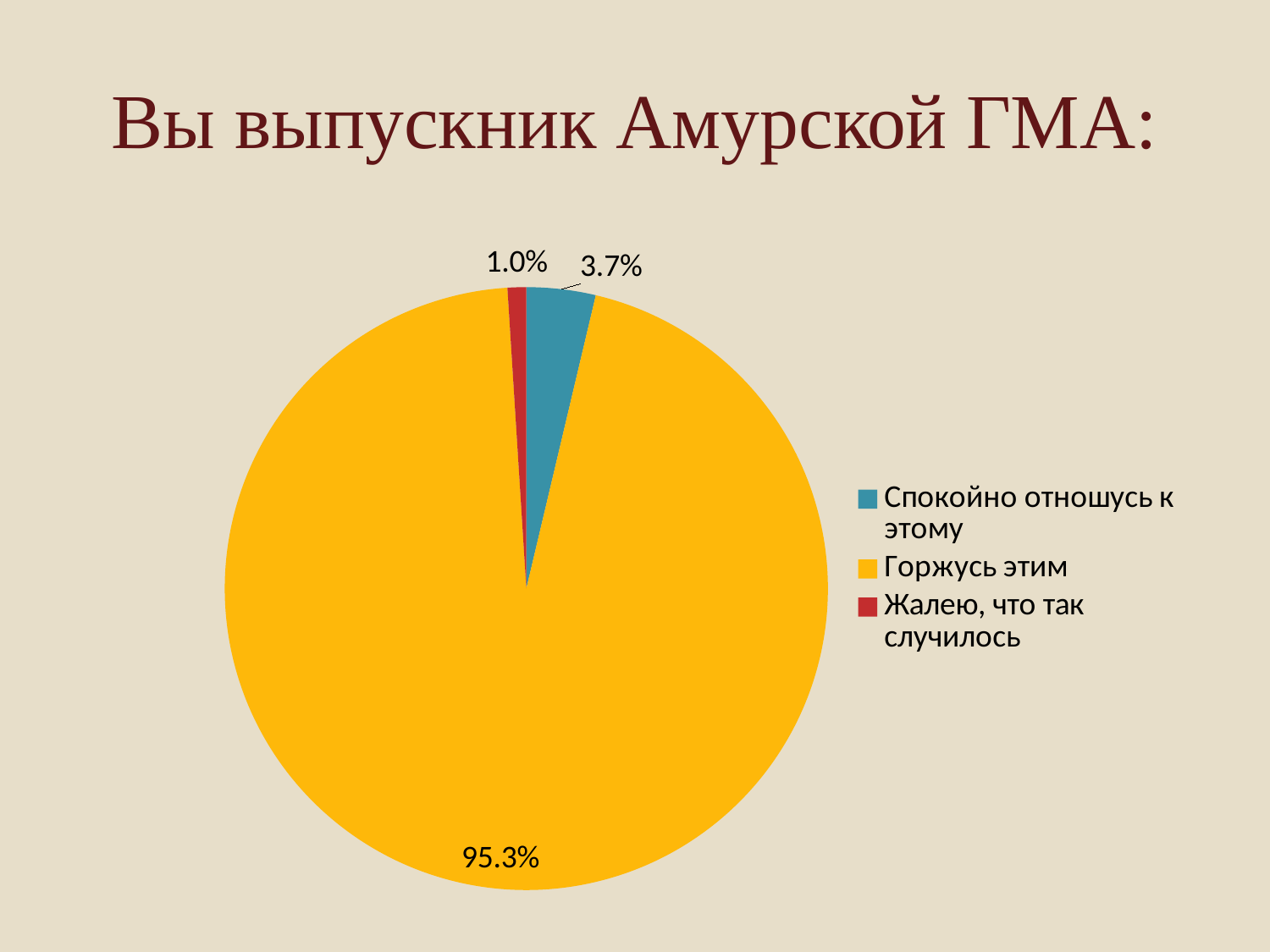
What is the title of the slide? Вы выпускник Амурской ГМА: What share of the pie does "Горжусь этим" have? 95.3% Which category has the smallest slice of the pie? Жалею, что так случилось Which is larger: the share for "Спокойно отношусь к этому" or for "Жалею, что так случилось"? Спокойно отношусь к этому What is the difference between the shares of "Спокойно отношусь к этому" and "Жалею, что так случилось"? 2.7% What share of the pie does "Жалею, что так случилось" have? 1.0% Which category has the largest slice of the pie? Горжусь этим What share of the pie does "Спокойно отношусь к этому" have? 3.7% What colour is the slice for "Горжусь этим"? Yellow How many categories does the pie chart show? 3 What is the difference between the shares of "Горжусь этим" and "Спокойно отношусь к этому"? 91.6% What kind of chart is shown on the slide? Pie chart